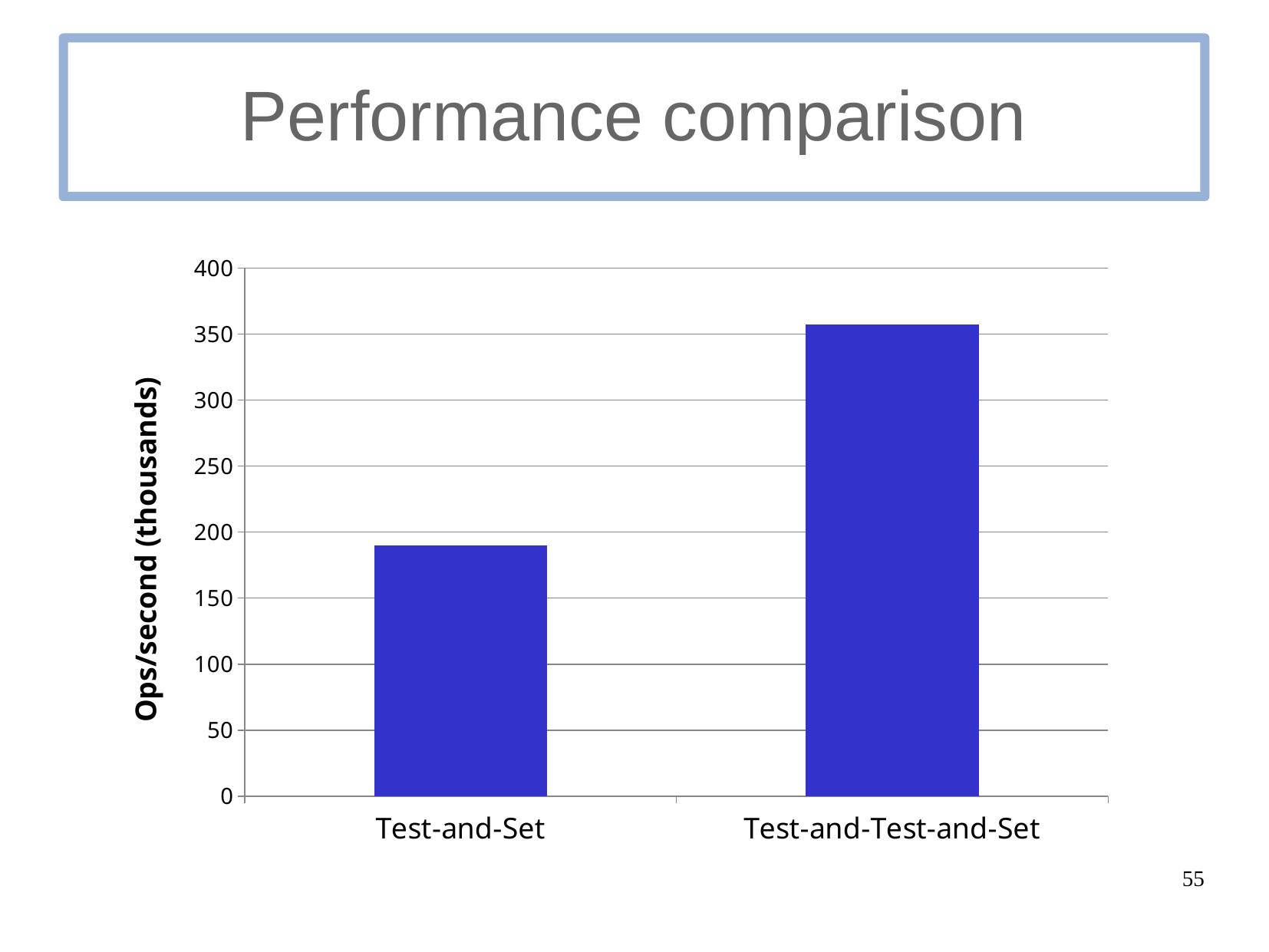
What kind of chart is shown on the slide? bar chart What is the label on the vertical axis of the chart? Ops/second (thousands) How many bars does the chart show? 2 Is the value for Test-and-Set greater or less than 200? less Is the value for Test-and-Set greater or less than 150? greater Which is larger, the value for Test-and-Set or the value for Test-and-Test-and-Set? Test-and-Test-and-Set Is the value for Test-and-Test-and-Set greater or less than 400? less What is the title of the slide containing the chart? Performance comparison Which category has the highest value? Test-and-Test-and-Set Which category has the lowest value? Test-and-Set